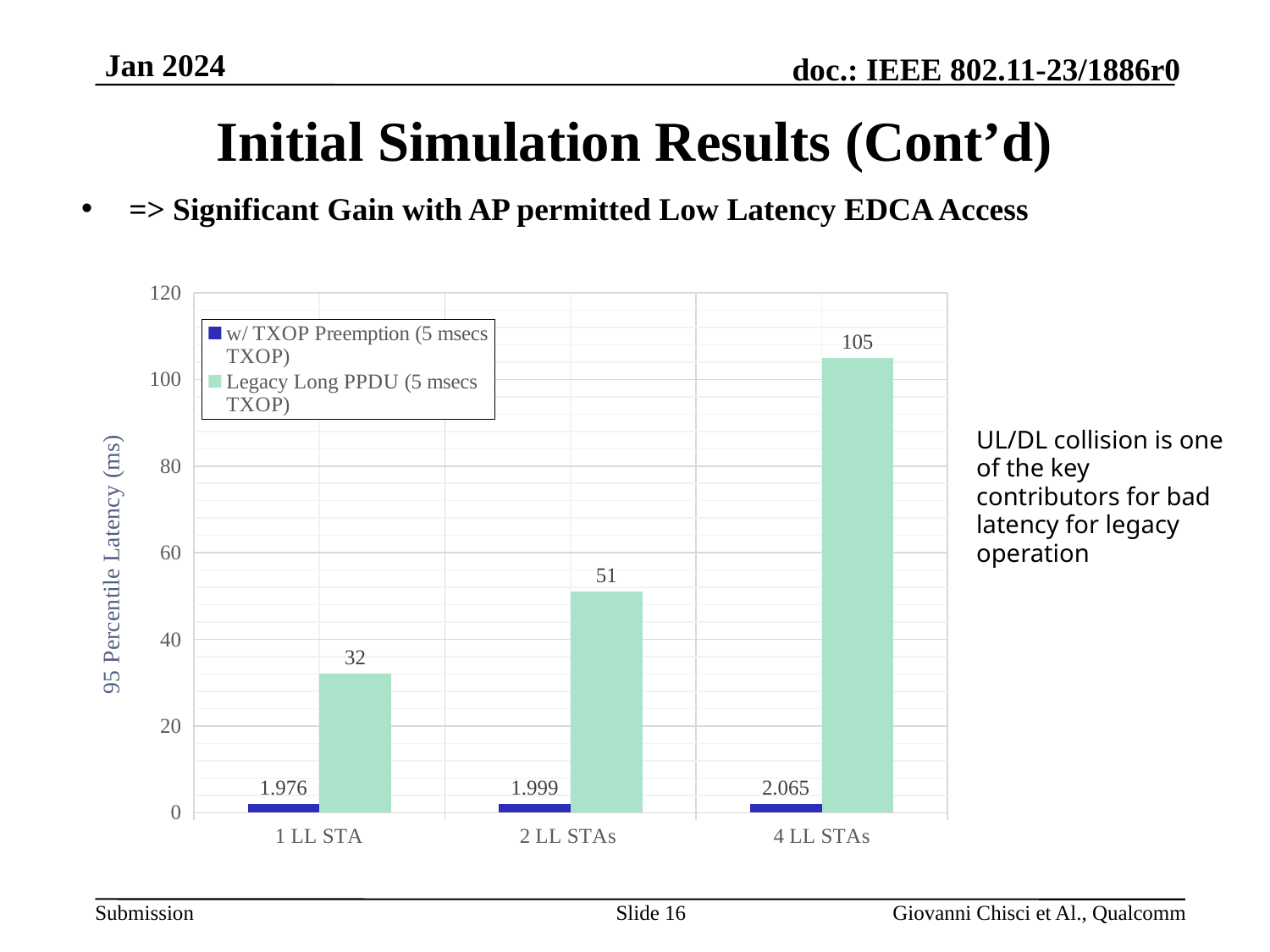
How many categories are shown on the x axis? 3 What is the value for w/ TXOP Preemption (5 msecs TXOP) at 4 LL STAs? 2.065 Do the Legacy Long PPDU (5 msecs TXOP) values rise or fall from 1 LL STA to 4 LL STAs? rise What is the value for Legacy Long PPDU (5 msecs TXOP) at 4 LL STAs? 105 At 2 LL STAs, which series has the larger value: w/ TXOP Preemption or Legacy Long PPDU? Legacy Long PPDU (5 msecs TXOP) Which category has the lowest value for Legacy Long PPDU (5 msecs TXOP)? 1 LL STA Which category has the highest value for Legacy Long PPDU (5 msecs TXOP)? 4 LL STAs How many series does the legend list? 2 What type of chart is shown on the slide? bar chart What is the difference between the Legacy Long PPDU values at 4 LL STAs and 2 LL STAs? 54 What is the value for w/ TXOP Preemption (5 msecs TXOP) at 1 LL STA? 1.976 What is the value for Legacy Long PPDU (5 msecs TXOP) at 2 LL STAs? 51